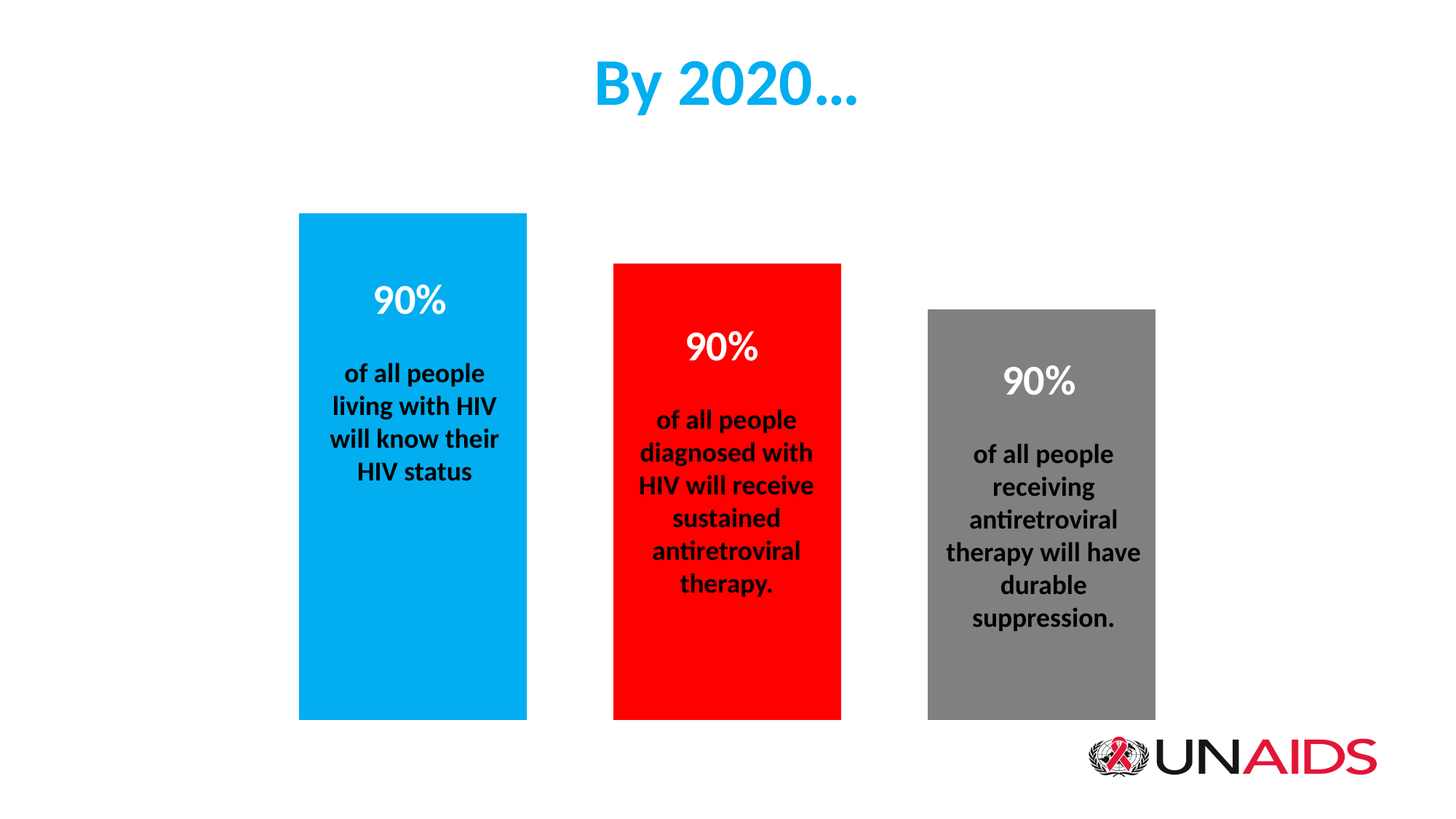
How many bars are shown on the chart? 3 What value is shown on the red bar for people diagnosed with HIV who will receive sustained antiretroviral therapy? 90% What is the title of the chart? By 2020... What percentage of all people receiving antiretroviral therapy will have durable suppression, according to the grey bar? 90% What kind of chart is shown on the slide? bar chart What colour is the bar for people diagnosed with HIV who will receive sustained antiretroviral therapy? red What percentage of all people living with HIV will know their HIV status by 2020, according to the chart? 90% Is the value for people living with HIV who will know their HIV status greater or less than 50%? greater